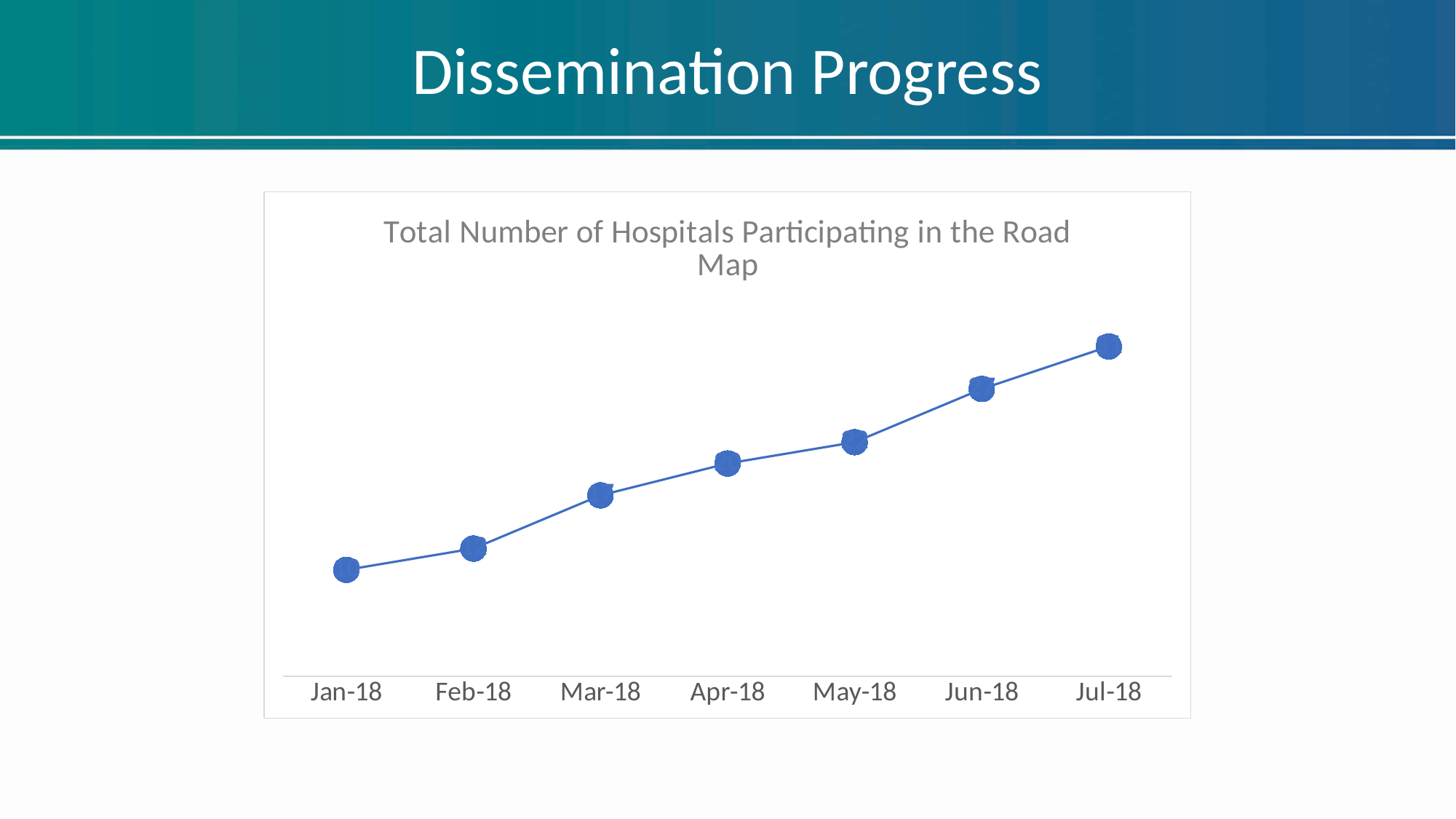
What is the title of the chart? Total Number of Hospitals Participating in the Road Map Which is larger, the value for Feb-18 or the value for Apr-18? Apr-18 Which is larger, the value for Mar-18 or the value for Jun-18? Jun-18 Which is larger, the value for May-18 or the value for Jan-18? May-18 What is the first month shown on the x axis? Jan-18 How many data points are plotted on the chart? 7 What kind of chart is shown on the slide? line chart Do the values rise or fall from Jan-18 to Jul-18? rise Which month has the lowest value? Jan-18 Which month has the highest value? Jul-18